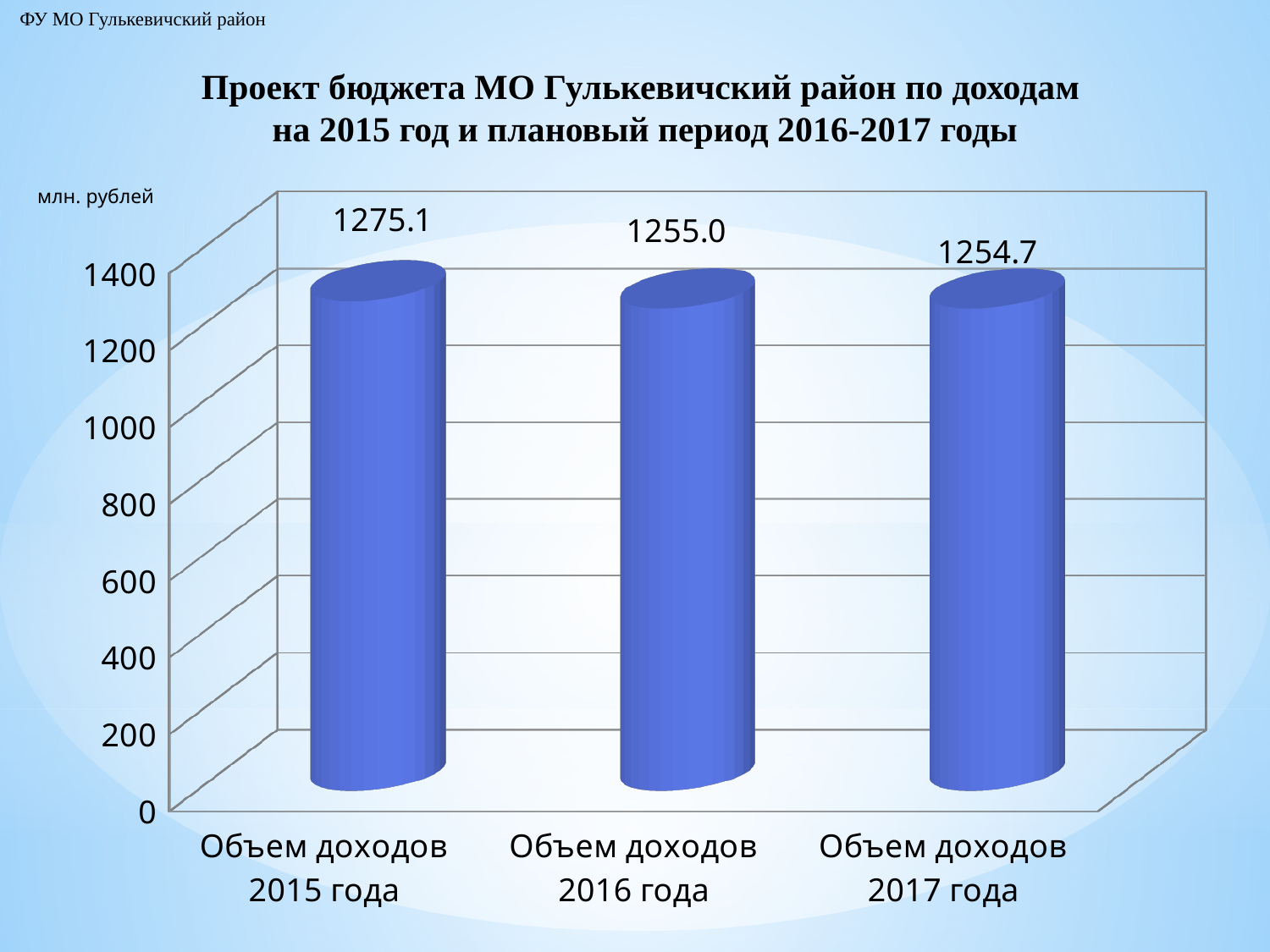
Is the value for Объем доходов 2016 года greater or less than 1200? greater What is the difference between the values for Объем доходов 2015 года and Объем доходов 2016 года? 20.1 How many categories are shown in the chart? 3 Which category has the highest value? Объем доходов 2015 года Do the values rise or fall from 2015 to 2017 along the x axis? fall What is the value for Объем доходов 2017 года? 1254.7 What is the value for Объем доходов 2015 года? 1275.1 What is the difference between the values for Объем доходов 2016 года and Объем доходов 2017 года? 0.3 Which is larger, the value for Объем доходов 2015 года or Объем доходов 2017 года? Объем доходов 2015 года What is the value for Объем доходов 2016 года? 1255.0 Which category has the lowest value? Объем доходов 2017 года What kind of chart is shown on the slide? bar chart